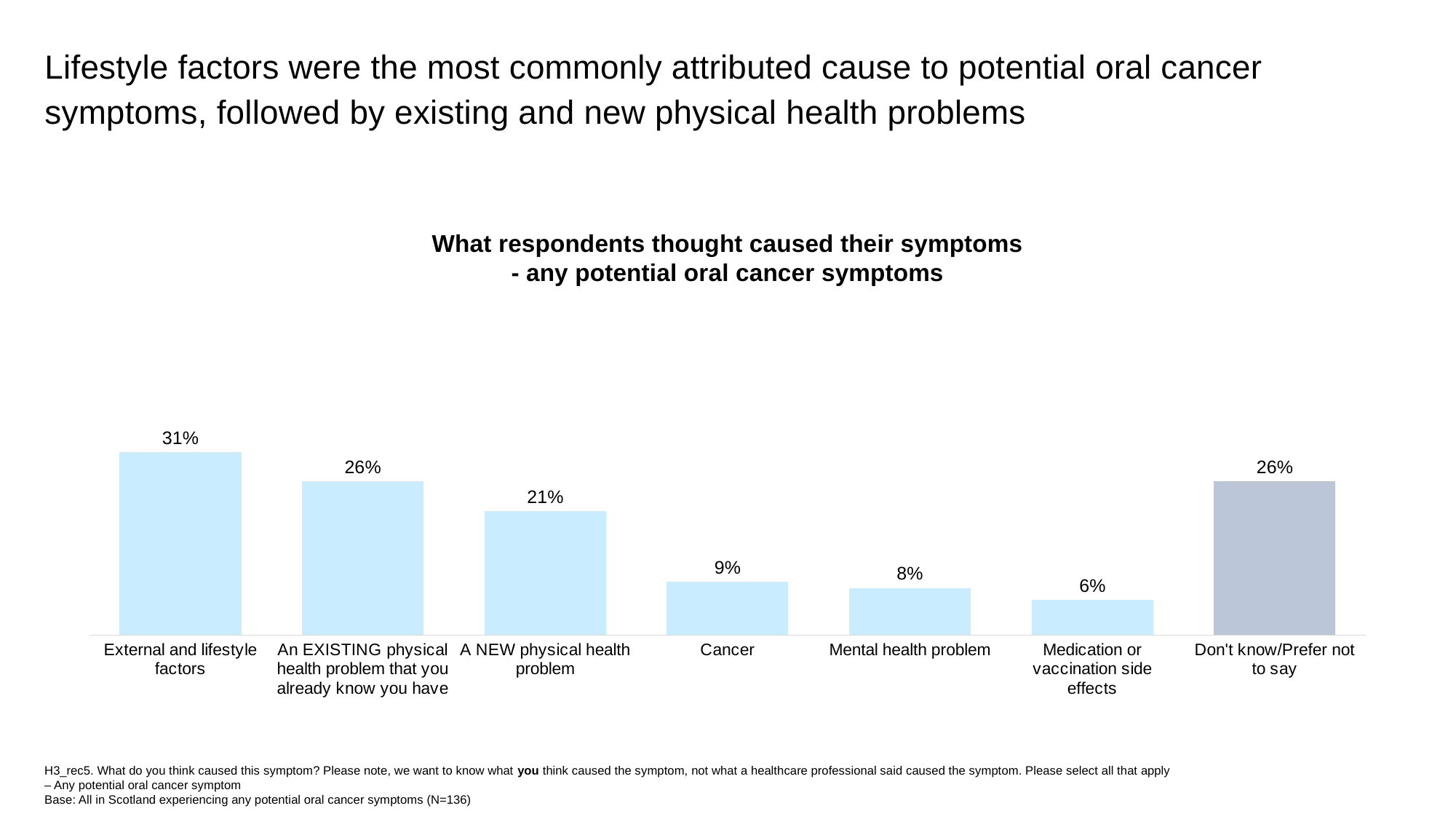
What is the value for 'A NEW physical health problem'? 21% How many categories are shown in the chart? 7 What percentage of respondents attributed their symptoms to external and lifestyle factors? 31% Which category has the highest value? External and lifestyle factors What percentage of respondents thought cancer caused their symptoms? 9% What is the difference between the values for 'Cancer' and 'Mental health problem'? 1% What is the difference between the value for 'External and lifestyle factors' and the value for 'A NEW physical health problem'? 10% What is the value for 'Medication or vaccination side effects'? 6% Which is larger: the value for 'An EXISTING physical health problem that you already know you have' or the value for 'Cancer'? An EXISTING physical health problem that you already know you have Which category has the lowest value? Medication or vaccination side effects What type of chart is shown on the slide? Bar chart What is the title of the chart? What respondents thought caused their symptoms - any potential oral cancer symptoms